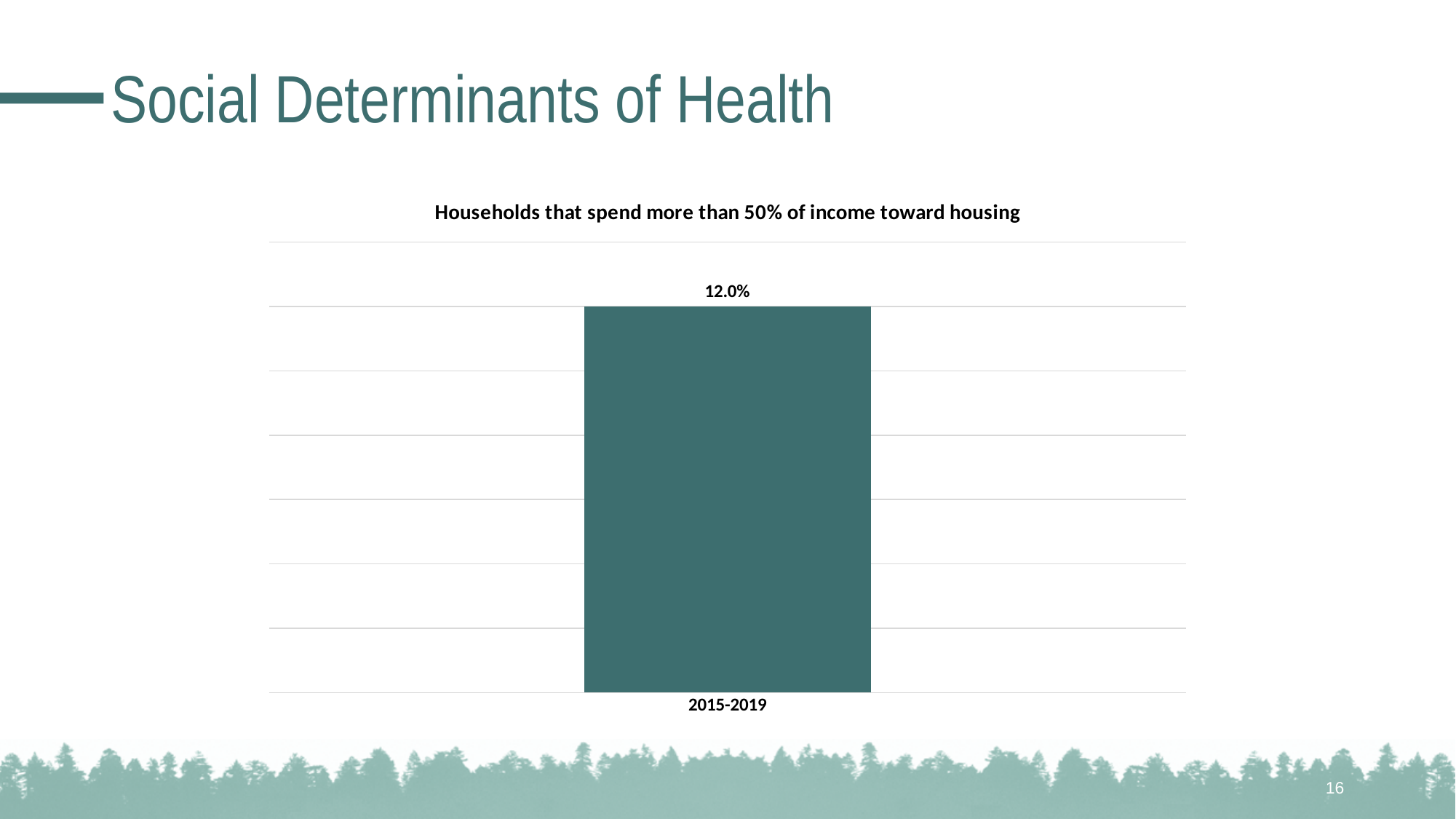
What is the value shown for 2015-2019 in the chart? 12.0% What is the category label on the x axis of the chart? 2015-2019 What is the title of the chart? Households that spend more than 50% of income toward housing Is the value for 2015-2019 greater or less than 10%? greater What kind of chart is shown on the slide? bar chart Is the value for 2015-2019 greater or less than 20%? less How many bars are plotted in the chart? 1